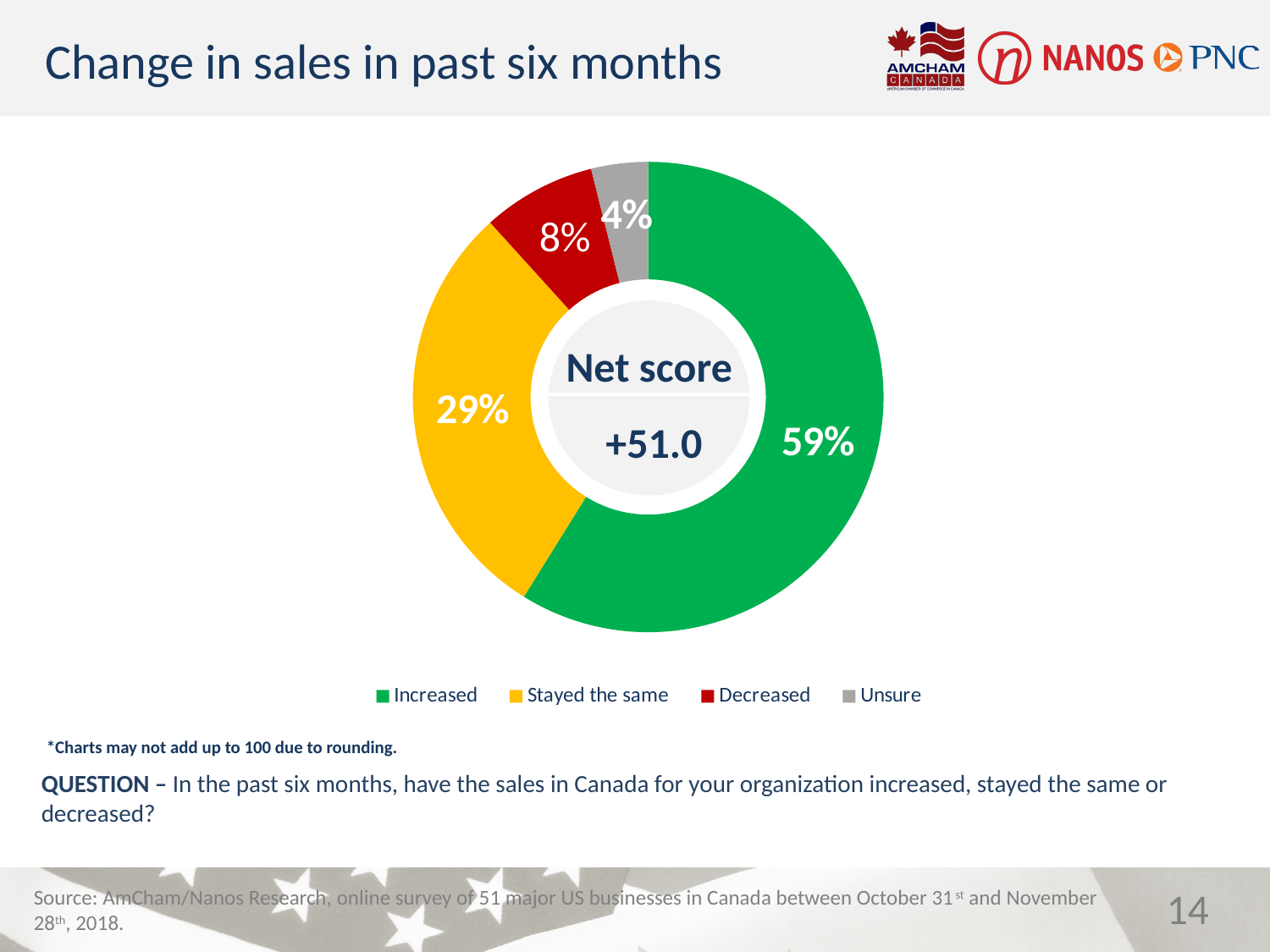
What percentage of respondents said sales increased? 59% Which category has the largest share of the chart? Increased What is the difference in percentage points between Increased and Stayed the same? 30 What net score is shown in the centre of the chart? +51.0 Which category has the smallest share of the chart? Unsure How many categories does the legend list? 4 What percentage of respondents said sales decreased? 8% What kind of chart is shown on the slide? Pie chart (doughnut) What percentage of respondents said sales stayed the same? 29% Which is larger, the share for Decreased or the share for Unsure? Decreased What is the title of the chart on the slide? Change in sales in past six months What percentage of respondents were unsure? 4%